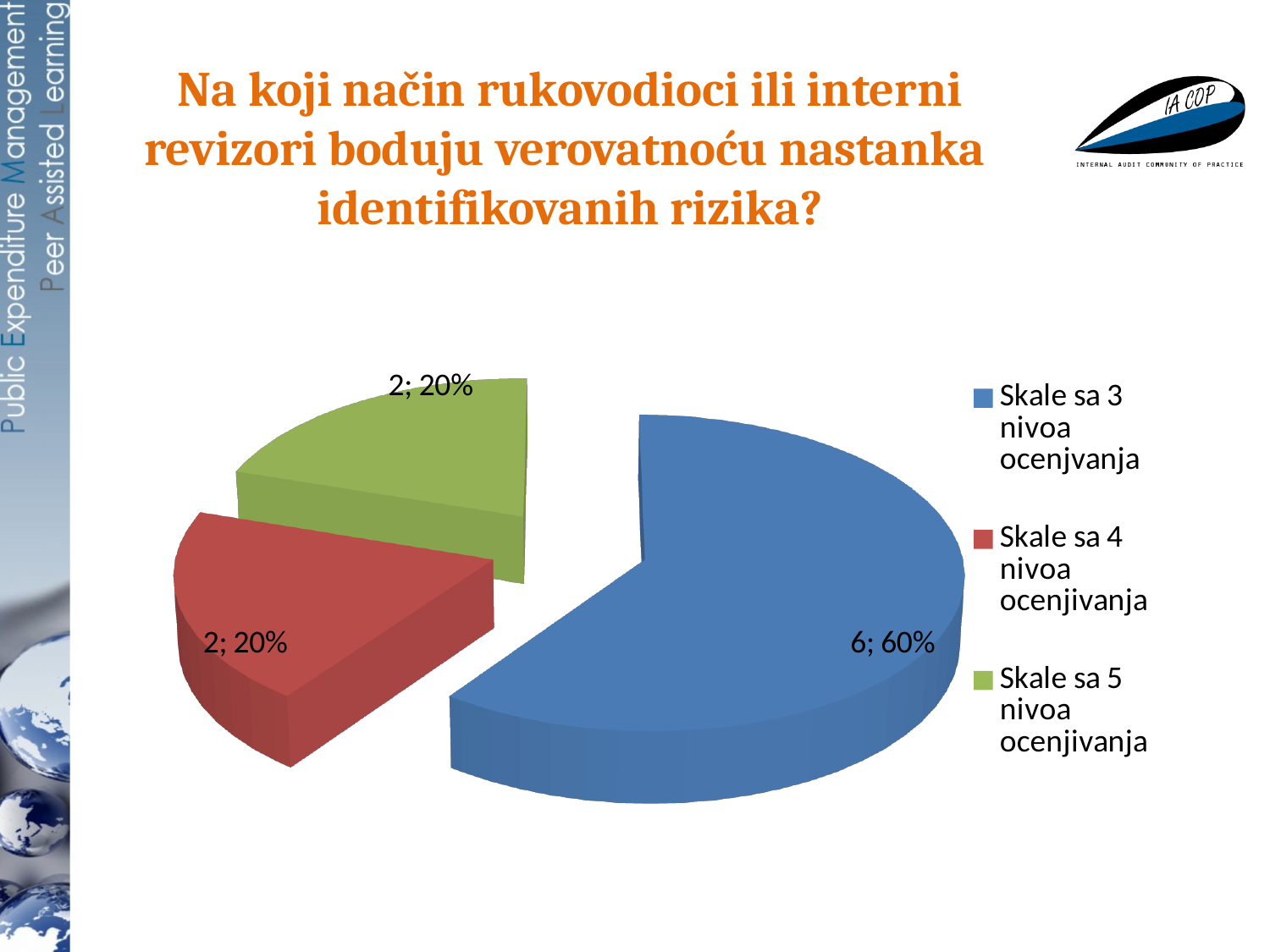
How many slices does the pie chart have? 3 How many entries does the legend list? 3 What is the count shown for "Skale sa 4 nivoa ocenjivanja"? 2 What share of the pie does "Skale sa 5 nivoa ocenjivanja" represent? 20% Which is larger, the value for "Skale sa 3 nivoa ocenjvanja" or for "Skale sa 4 nivoa ocenjivanja"? Skale sa 3 nivoa ocenjvanja Which category has the largest slice of the pie? Skale sa 3 nivoa ocenjvanja What is the count shown for "Skale sa 3 nivoa ocenjvanja"? 6 What is the difference between the count for "Skale sa 3 nivoa ocenjvanja" and the count for "Skale sa 5 nivoa ocenjivanja"? 4 What colour is the slice for "Skale sa 5 nivoa ocenjivanja"? green What kind of chart is shown on the slide? pie chart What share of the pie does "Skale sa 3 nivoa ocenjvanja" represent? 60% What is the total of the counts shown on all slices of the pie? 10